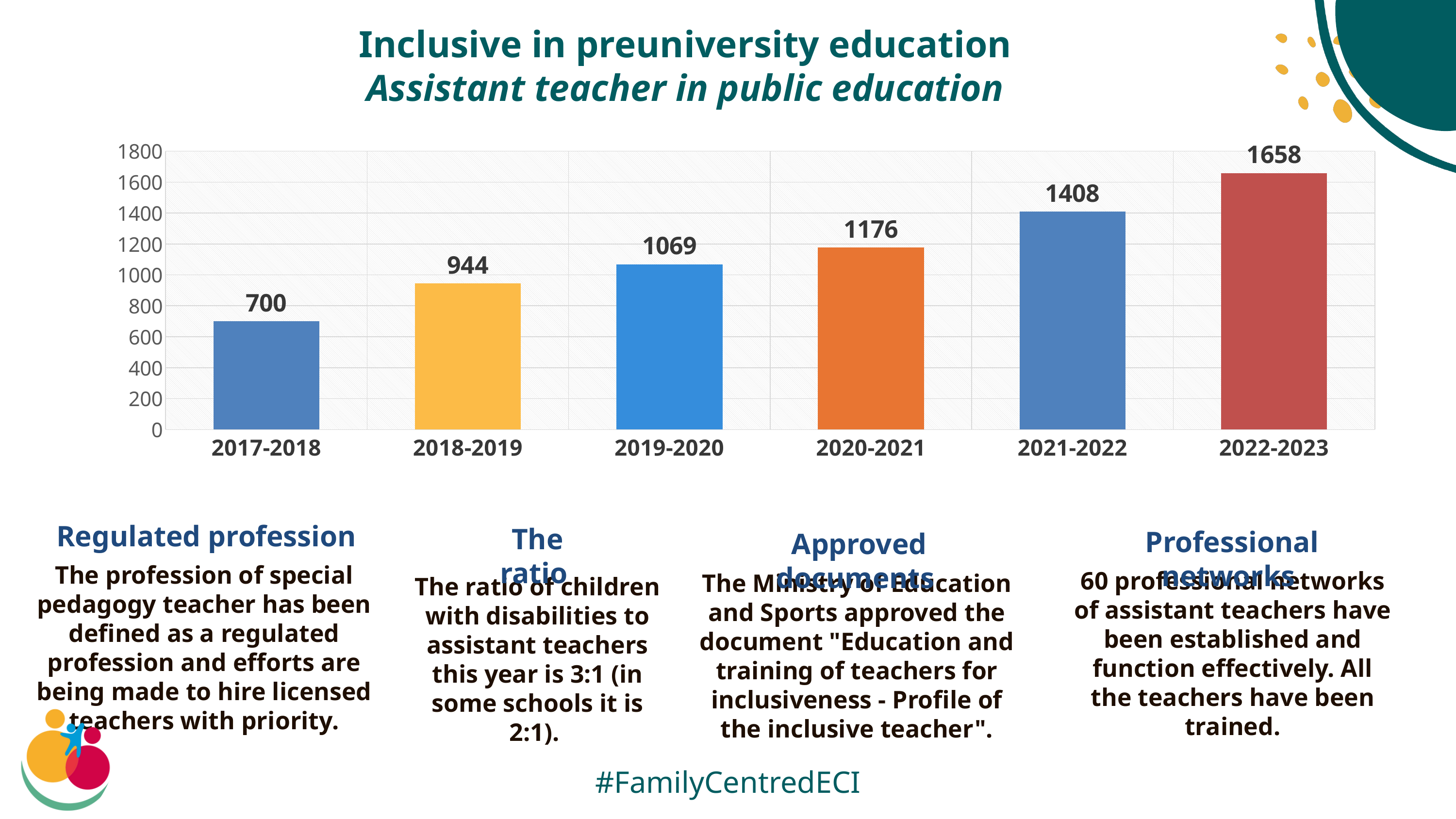
What is the difference between the values for 2022-2023 and 2021-2022? 250 What kind of chart is shown on the slide? bar chart What is the difference between the values for 2018-2019 and 2017-2018? 244 Which school year has the highest value? 2022-2023 Is the value for 2021-2022 greater or less than 1200? greater Which is larger, the value for 2019-2020 or the value for 2020-2021? 2020-2021 Which school year has the lowest value? 2017-2018 How many school years are shown on the x axis? 6 What is the value for 2022-2023? 1658 What is the value for 2017-2018? 700 Do the values rise or fall from 2017-2018 to 2022-2023? rise What is the value for 2020-2021? 1176